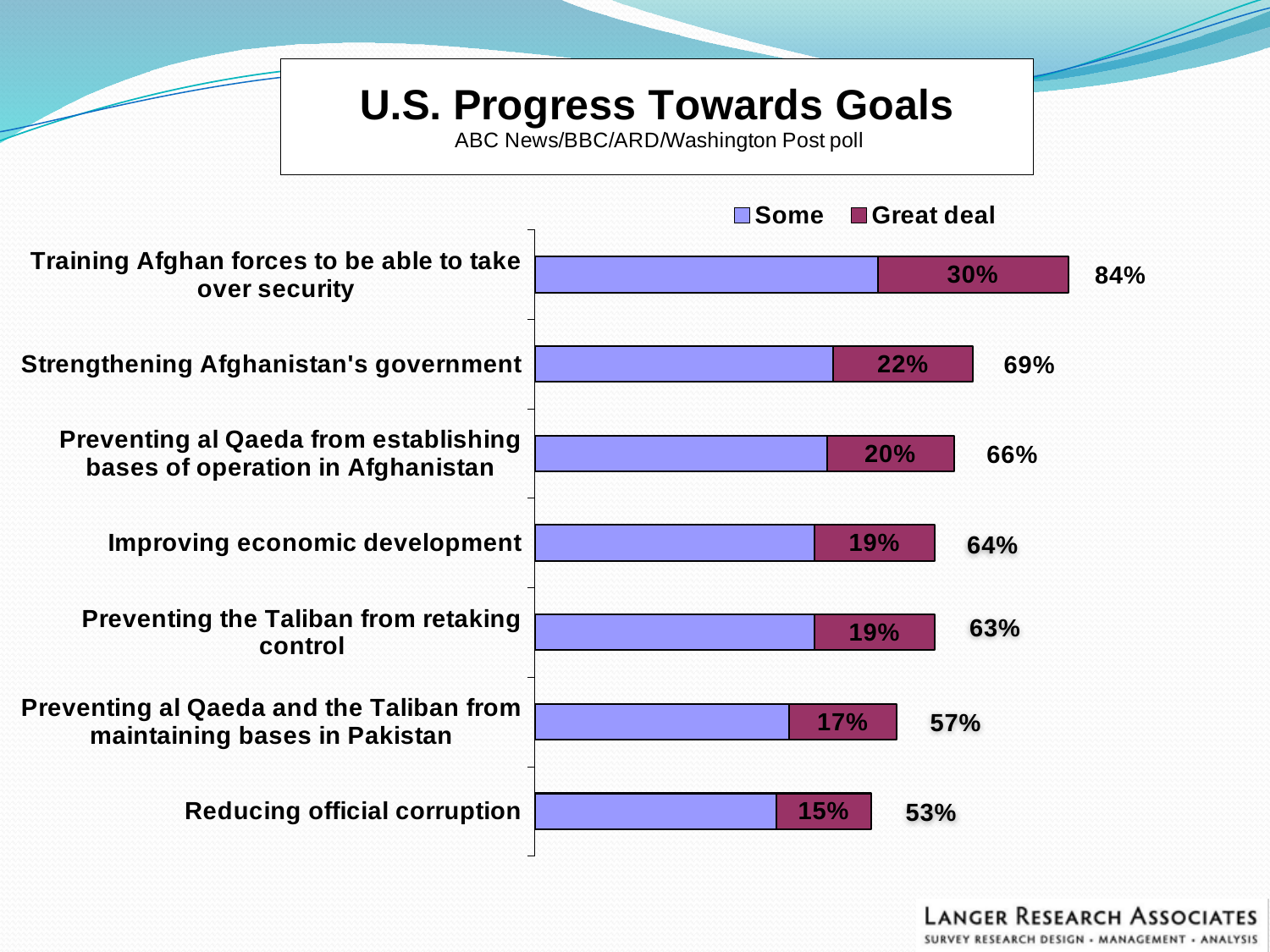
What is the total for 'Strengthening Afghanistan's government'? 69% Which goal has the highest total? Training Afghan forces to be able to take over security What is the 'Great deal' value for 'Reducing official corruption'? 15% What is the difference between the totals for 'Training Afghan forces to be able to take over security' and 'Reducing official corruption'? 31% How many series does the legend list? 2 What type of chart is shown on the slide? bar chart Which is larger: the 'Great deal' value for 'Strengthening Afghanistan's government' or for 'Preventing al Qaeda and the Taliban from maintaining bases in Pakistan'? Strengthening Afghanistan's government What is the title of the chart? U.S. Progress Towards Goals Which goal has the lowest 'Great deal' value? Reducing official corruption What is the 'Great deal' value for 'Training Afghan forces to be able to take over security'? 30% How many goals (categories) are shown in the chart? 7 What is the total for 'Preventing al Qaeda from establishing bases of operation in Afghanistan'? 66%